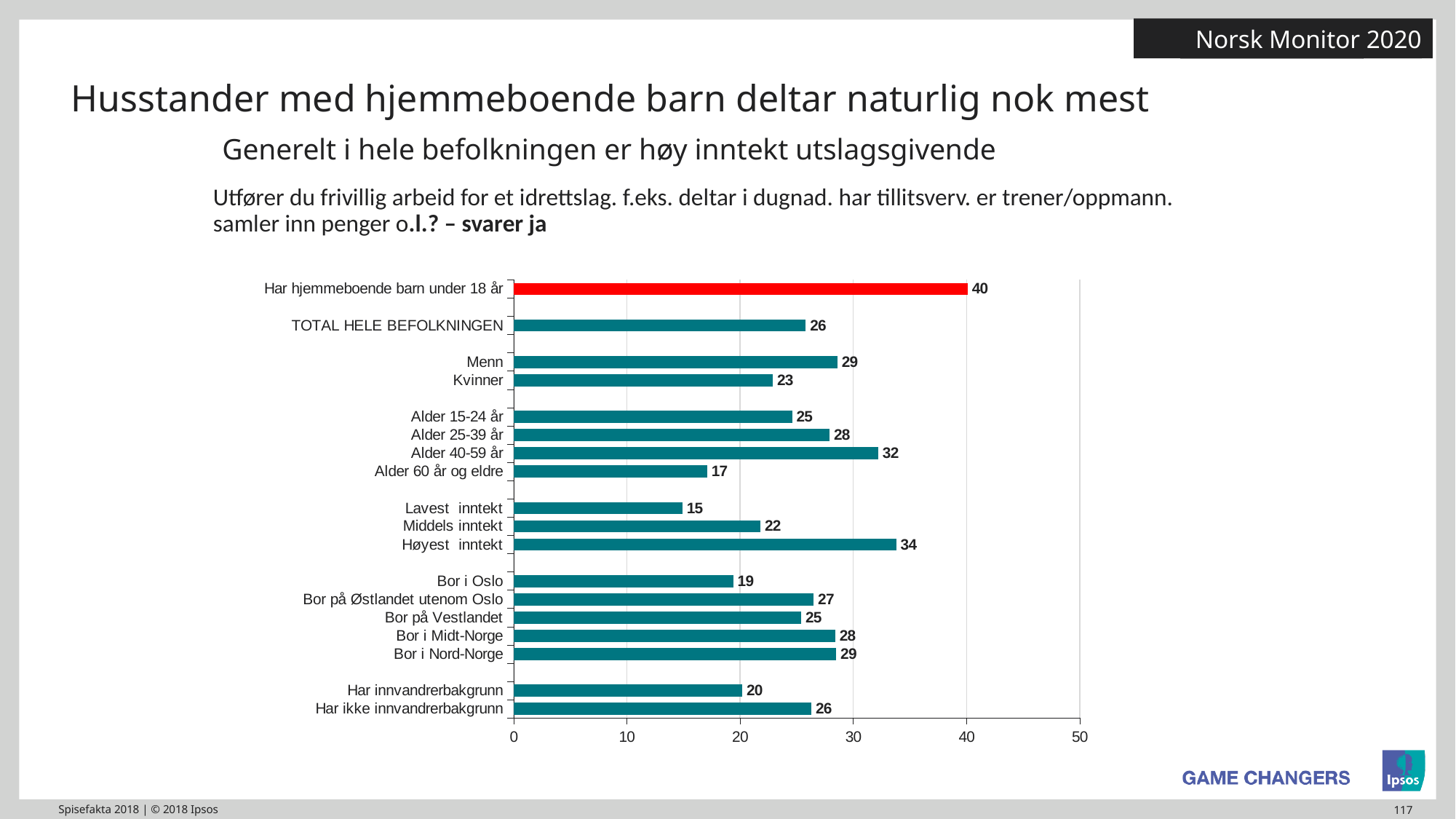
What is the difference between 'Høyest inntekt' and 'Lavest inntekt'? 19 Which category has the lowest value? Lavest inntekt Which is larger, the value for 'Bor i Oslo' or 'Bor på Østlandet utenom Oslo'? Bor på Østlandet utenom Oslo What is the value for 'TOTAL HELE BEFOLKNINGEN'? 26 What kind of chart is shown on the slide? bar chart How many categories are plotted in the chart? 18 What is the difference between the values for 'Menn' and 'Kvinner'? 6 What is the value for 'Har hjemmeboende barn under 18 år'? 40 Is the value for 'Alder 40-59 år' greater or less than 30? greater What is the value for 'Alder 60 år og eldre'? 17 Which category has the highest value? Har hjemmeboende barn under 18 år Which bar is coloured red rather than teal? Har hjemmeboende barn under 18 år